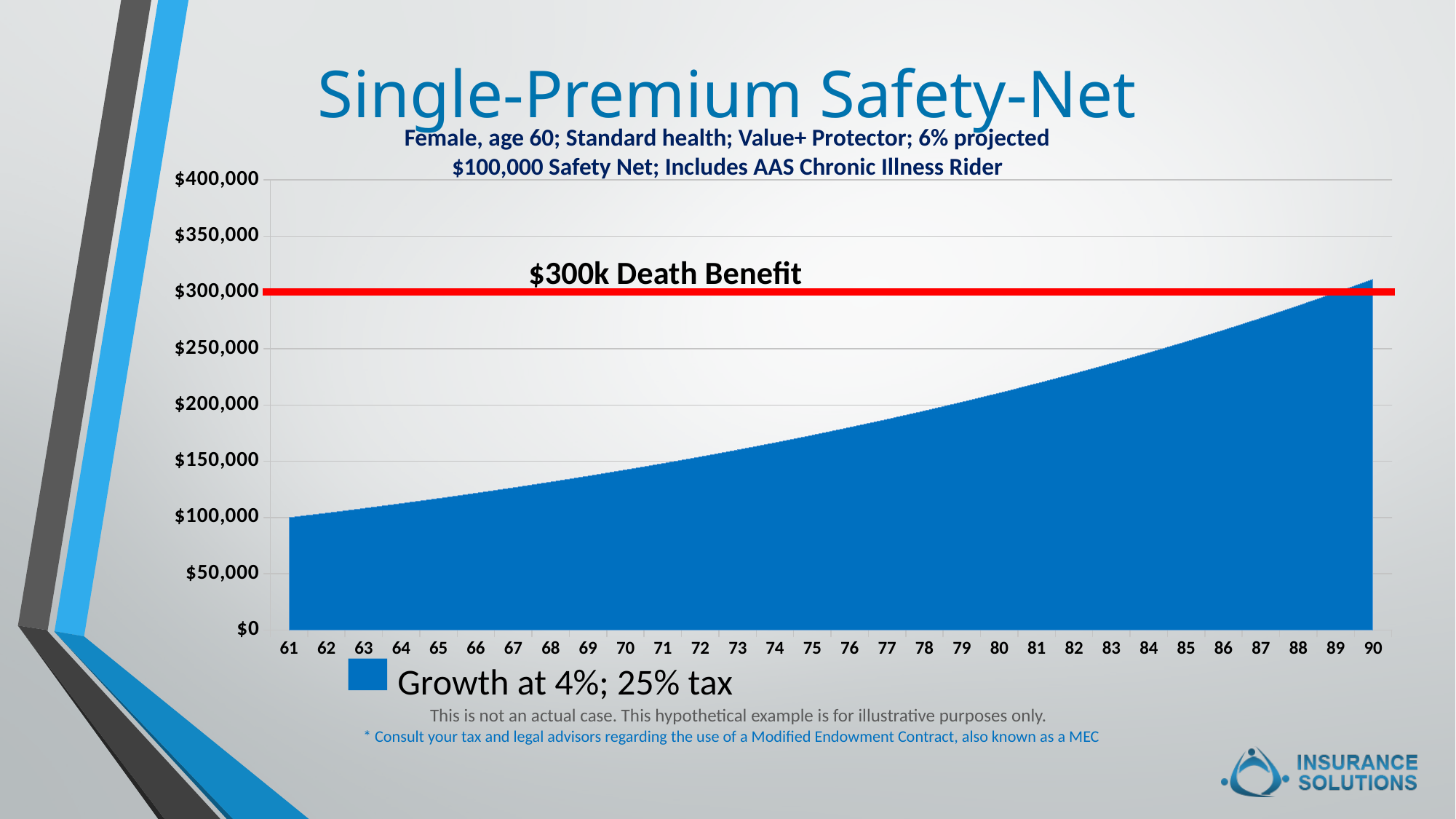
At which age is the plotted value lowest? 61 How many ages are plotted along the x axis? 30 At which age is the plotted value highest? 90 Which is larger, the value at age 80 or the value at age 70? age 80 How many series does the legend list? 1 Is the value at age 88 greater or less than $300,000? less Do the plotted values rise or fall as age increases from 61 to 90? rise Is the value at age 75 greater or less than $200,000? less What kind of chart is shown on the slide? area chart What does the red horizontal line on the chart represent? $300k Death Benefit Is the value at age 90 greater or less than $300,000? greater